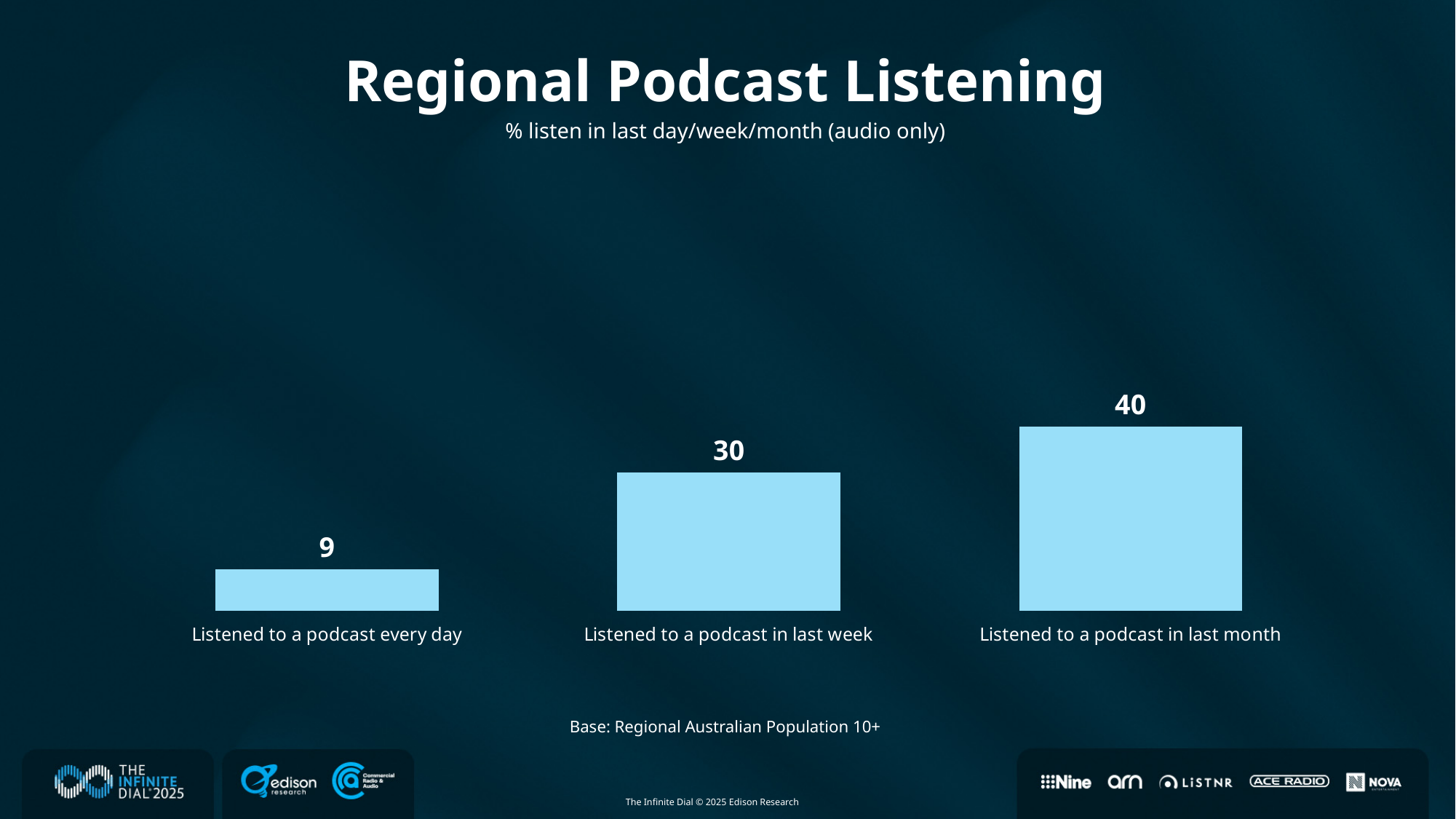
What is the value for 'Listened to a podcast every day'? 9 What is the difference between the values for 'Listened to a podcast in last week' and 'Listened to a podcast every day'? 21 What kind of chart is shown on the slide? Bar chart Do the values rise or fall from left to right across the categories? Rise What is the title of the chart? Regional Podcast Listening Which is larger: the value for 'Listened to a podcast in last week' or 'Listened to a podcast every day'? Listened to a podcast in last week What is the value for 'Listened to a podcast in last week'? 30 How many categories are shown in the chart? 3 What is the difference between the values for 'Listened to a podcast in last month' and 'Listened to a podcast in last week'? 10 Which category has the lowest value? Listened to a podcast every day Which category has the highest value? Listened to a podcast in last month What is the value for 'Listened to a podcast in last month'? 40